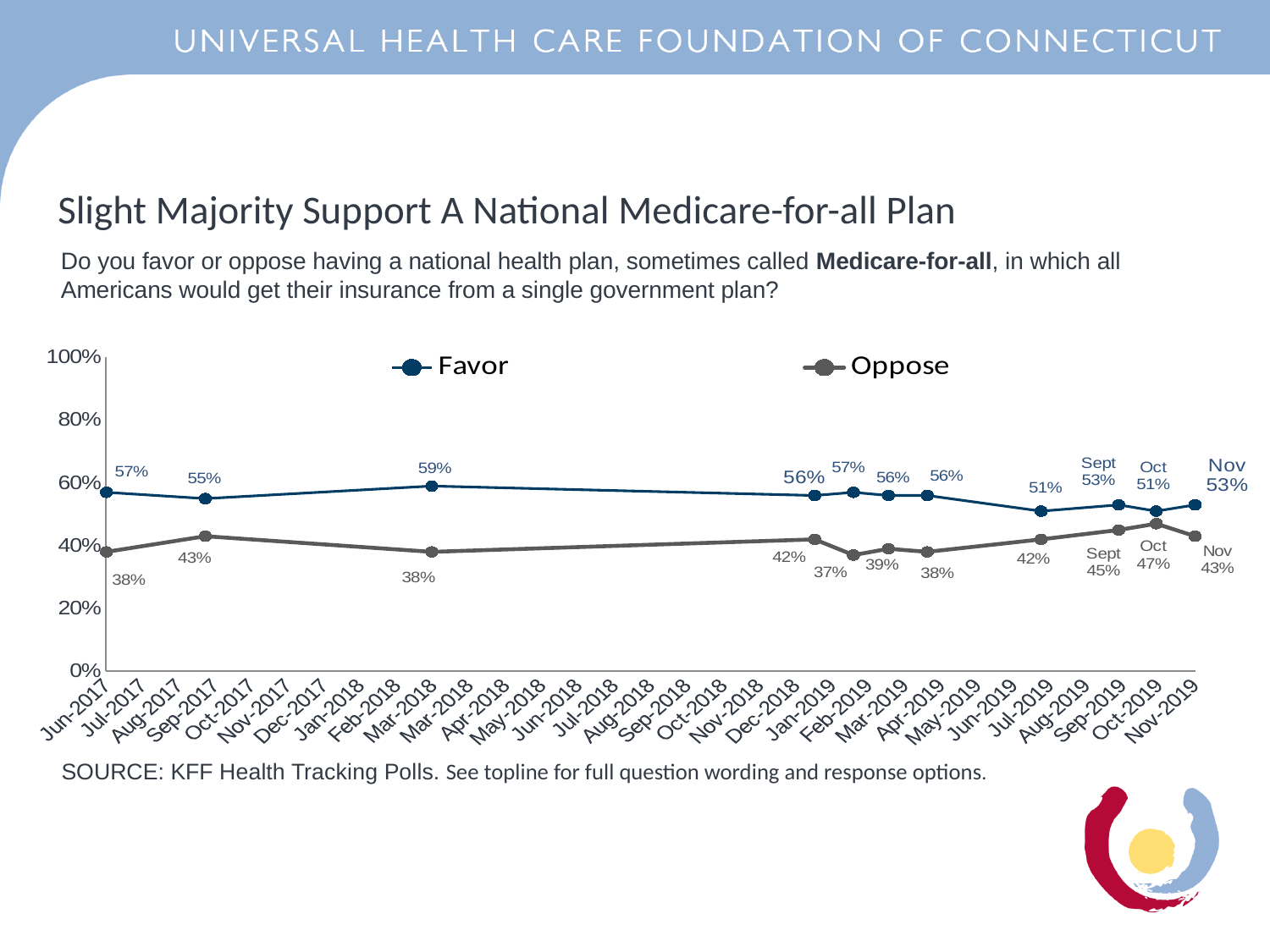
What is the Oppose value for Oct 2019? 47% In Nov 2019, what is the difference between the Favor and Oppose values? 10 percentage points What is the Favor value for Sept 2019? 53% How many series does the chart's legend list? 2 What are the two series named in the chart's legend? Favor and Oppose What is the Oppose value for Nov 2019? 43% What kind of chart is shown on the slide? Line chart In Oct 2019, which is larger, the Favor value or the Oppose value? Favor What is the Favor value for Nov 2019? 53% What is the highest Oppose value shown on the chart? 47% What is the lowest Oppose value shown on the chart? 37% What is the highest Favor value shown on the chart? 59%